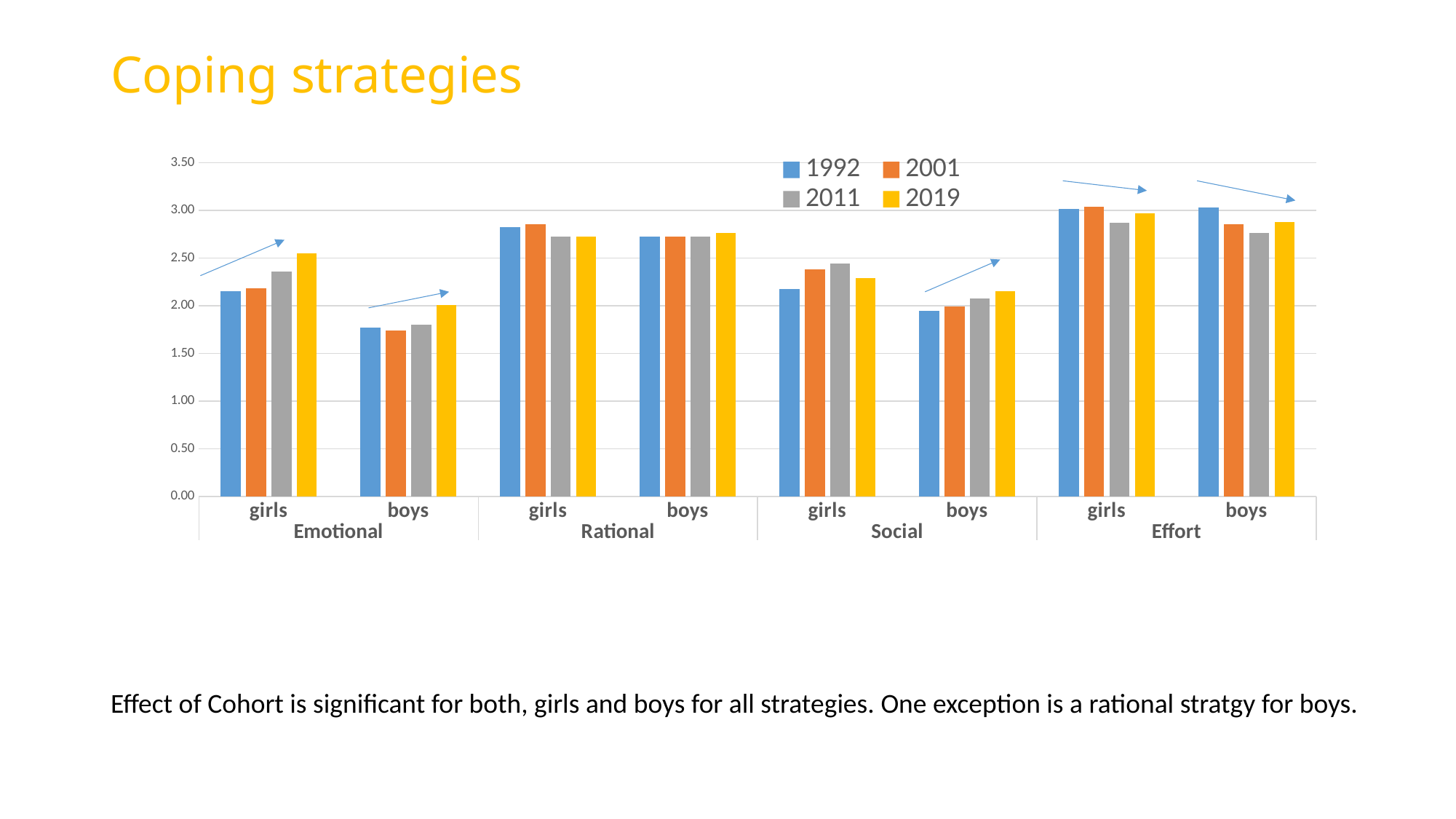
How many series does the legend list? 4 Is the value for Emotional boys in 2001 greater or less than 2.00? less Which cohort has the highest value for Social boys? 2019 Is the value for Social girls in 1992 greater or less than 2.00? greater Do the values for Emotional girls rise or fall from 1992 to 2019? rise How many coping strategies are shown along the x axis? 4 What kind of chart is shown on the slide? bar chart Which cohort has the lowest value for Effort boys? 2011 Which cohort has the highest value for Emotional girls? 2019 Is the value for Rational girls in 1992 greater or less than 2.50? greater Which is larger in 2019: the value for Emotional girls or Emotional boys? Emotional girls Which colour represents the 2019 cohort in the legend? yellow